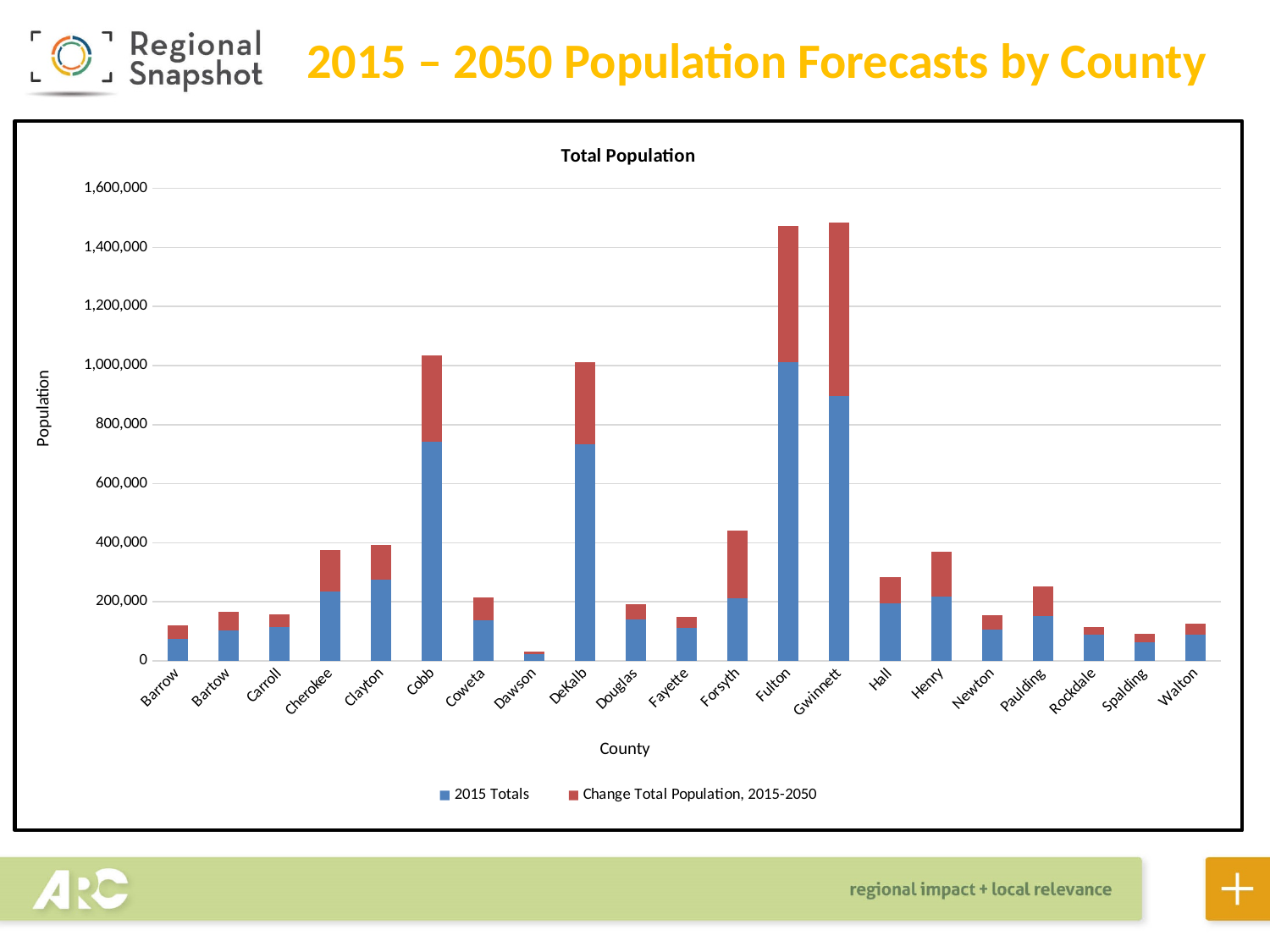
What kind of chart is shown on the slide? Stacked bar chart Which county has the lowest total population bar? Dawson How many series does the legend list? 2 What is the title of the chart? Total Population Is the total bar for Gwinnett greater or less than 1,400,000? greater Which county has the largest 2015 Totals (blue) segment? Fulton What label is shown on the y axis of the chart? Population How many counties are shown on the x axis? 21 Is the total bar for Forsyth greater or less than 400,000? greater Which county has the taller total bar, Forsyth or Henry? Forsyth Is the 2015 Totals segment for Cobb greater or less than 800,000? less Which county has the largest Change Total Population, 2015-2050 (red) segment? Gwinnett